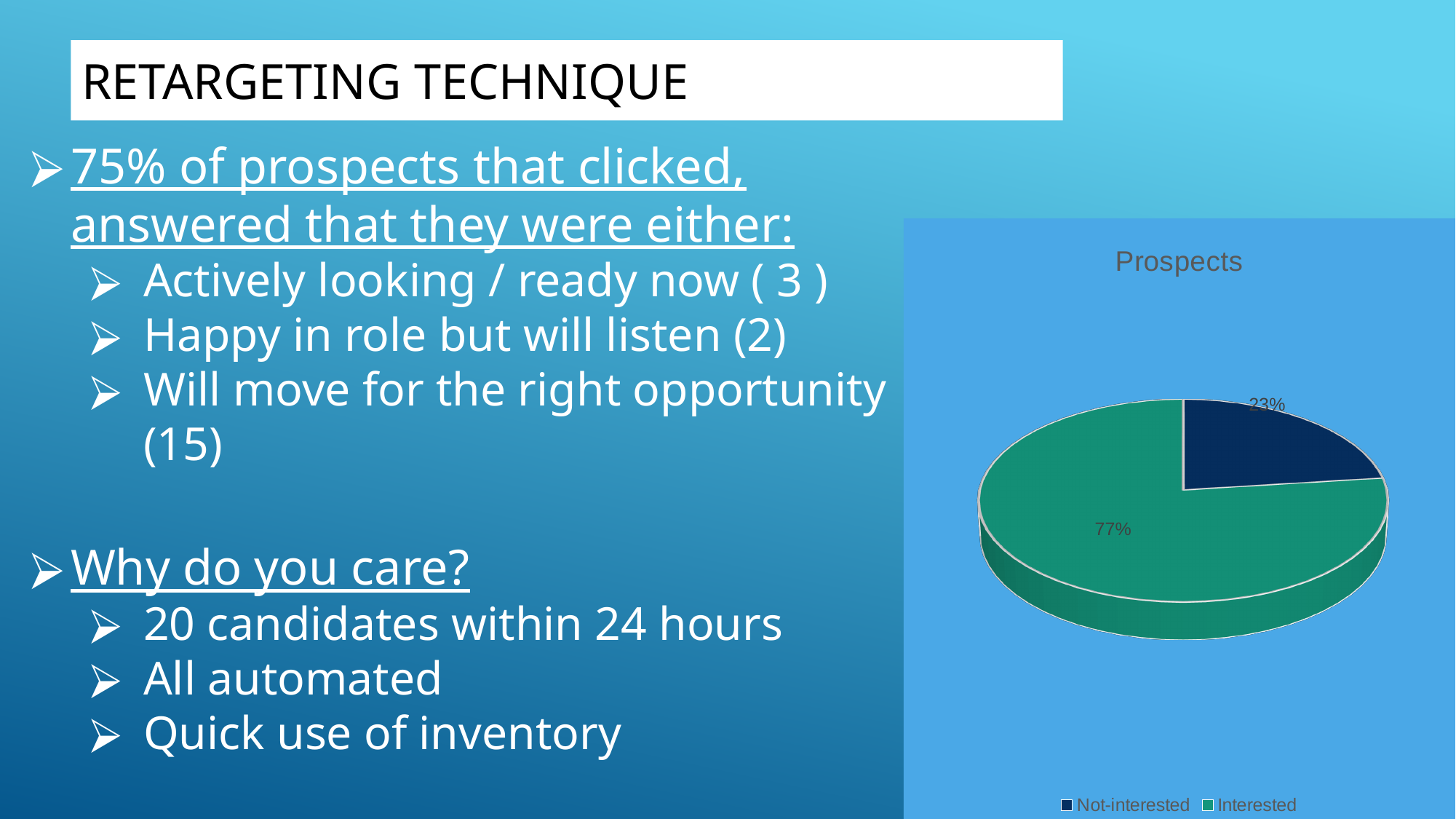
What type of chart is shown on the slide? pie chart What is the difference in percentage points between the Interested and Not-interested slices? 54 What percentage of the pie is labelled Interested? 77% Which slice of the pie is the largest? Interested What percentage of the pie is labelled Not-interested? 23% What is the title of the chart? Prospects How many slices does the pie chart have? 2 What colour is the Interested slice in the pie chart? green Which slice of the pie is the smallest? Not-interested How many entries does the legend list? 2 Which is larger, the Interested slice or the Not-interested slice? Interested Is the Not-interested share of the pie greater or less than 50%? less